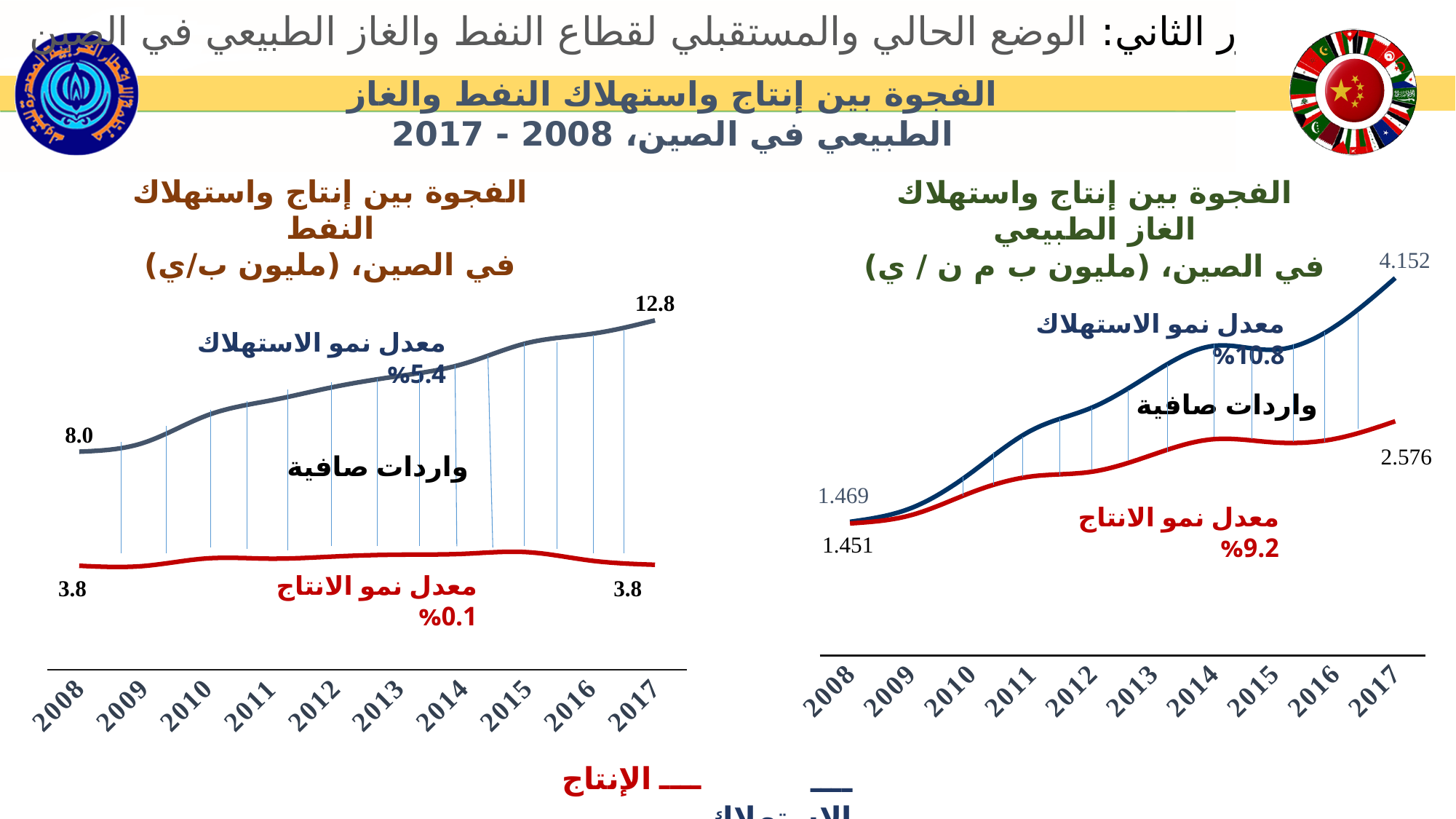
What type of chart is the left chart (oil gap in China)? Line chart On the right chart (natural gas gap in China), what is the difference between consumption and production in 2017? 1.576 On the right chart (natural gas gap in China), what is the production value in 2017? 2.576 On the left chart (oil gap in China), what is the consumption value in 2017? 12.8 How many years are shown on the x axis of the right chart (natural gas gap in China)? 10 On the right chart (natural gas gap in China), which is larger in 2017, consumption or production? Consumption On the left chart (oil gap in China), what is the production value in 2017? 3.8 On the left chart (oil gap in China), what is the consumption value in 2008? 8.0 On the right chart (natural gas gap in China), what is the annotated consumption growth rate? 10.8% On the right chart (natural gas gap in China), what is the production value in 2008? 1.451 On the left chart (oil gap in China), by how much did consumption increase from 2008 to 2017? 4.8 On the right chart (natural gas gap in China), what is the consumption value in 2017? 4.152